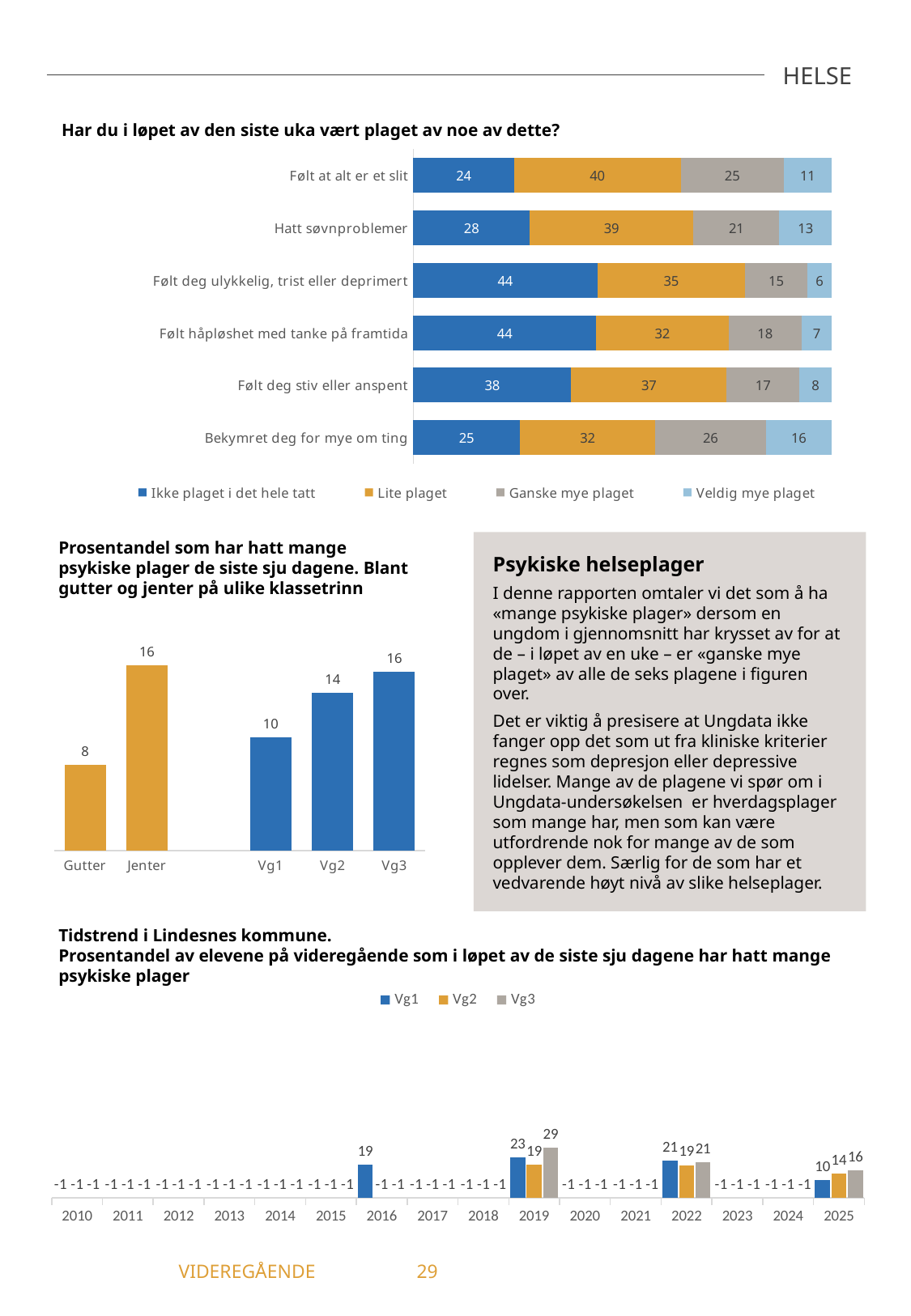
In the top chart 'Har du i løpet av den siste uka vært plaget av noe av dette?', what is the difference between 'Ganske mye plaget' for 'Bekymret deg for mye om ting' and for 'Følt deg ulykkelig, trist eller deprimert'? 11 In the top chart 'Har du i løpet av den siste uka vært plaget av noe av dette?', which category has the highest value for 'Ikke plaget i det hele tatt'? Følt deg ulykkelig, trist eller deprimert and Følt håpløshet med tanke på framtida (both 44) In the bottom chart 'Tidstrend i Lindesnes kommune', which is larger in 2025: Vg1 or Vg2? Vg2 In the top chart 'Har du i løpet av den siste uka vært plaget av noe av dette?', how many series does the legend list? 4 In the top chart 'Har du i løpet av den siste uka vært plaget av noe av dette?', what is the value for 'Veldig mye plaget' in the 'Bekymret deg for mye om ting' bar? 16 In the bottom chart 'Tidstrend i Lindesnes kommune', what is the value for Vg3 in 2019? 29 In the top chart 'Har du i løpet av den siste uka vært plaget av noe av dette?', what is the value for 'Lite plaget' in the 'Følt at alt er et slit' bar? 40 What kind of chart is the bottom chart 'Tidstrend i Lindesnes kommune'? Bar chart In the top chart 'Har du i løpet av den siste uka vært plaget av noe av dette?', how many categories are shown? 6 In the middle-left chart 'Prosentandel som har hatt mange psykiske plager de siste sju dagene', which category has the lowest value? Gutter In the middle-left chart 'Prosentandel som har hatt mange psykiske plager de siste sju dagene', what is the difference between Vg3 and Vg1? 6 In the middle-left chart 'Prosentandel som har hatt mange psykiske plager de siste sju dagene', what is the value for Jenter? 16